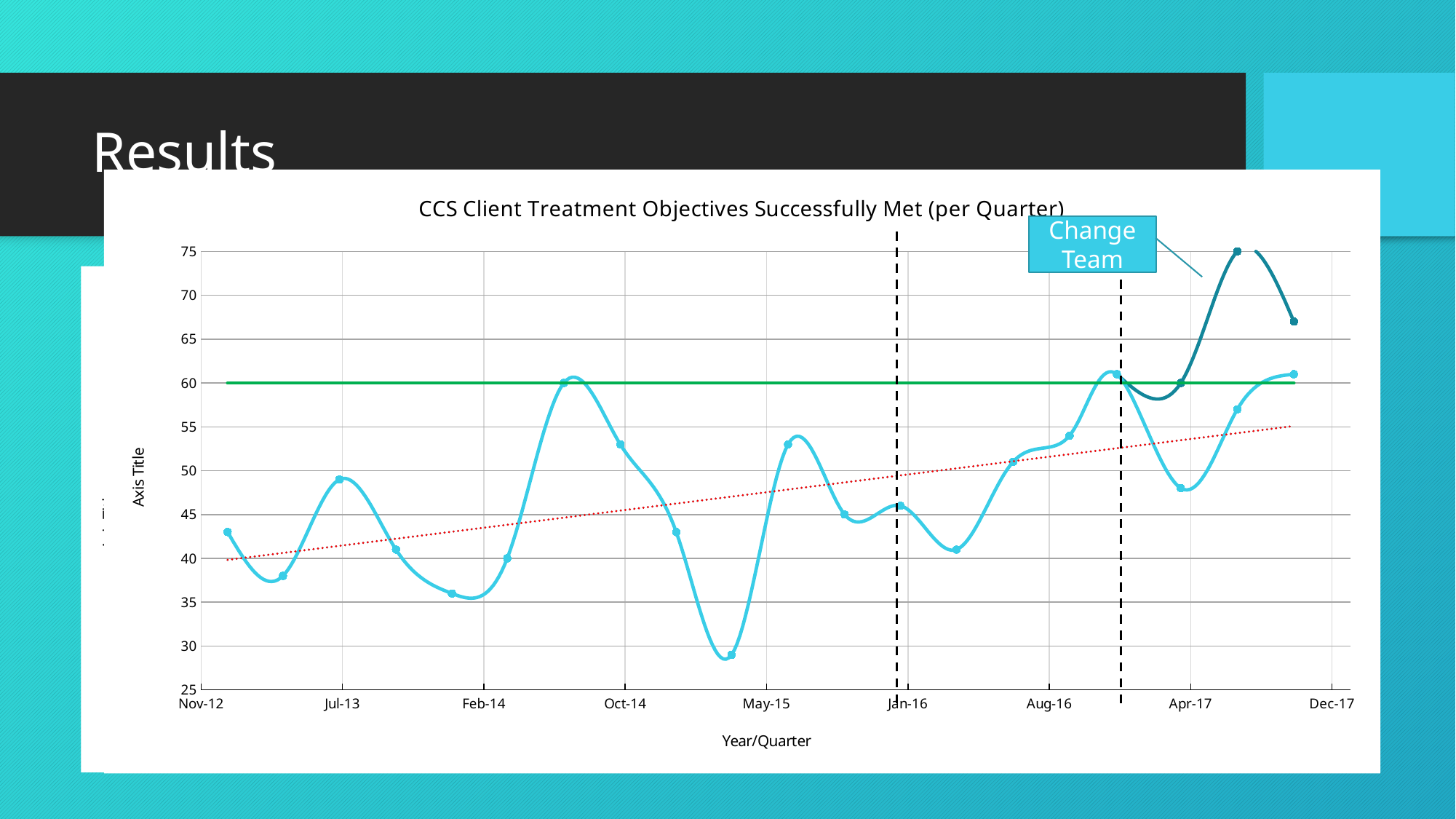
Is the lowest point of the light blue line greater or less than 35? less What kind of chart is shown on the slide? line chart Between which two x-axis labels does the highest point on the chart fall? Apr-17 and Dec-17 Does the red dotted trend line rise or fall from left to right? rises How many dashed vertical lines are drawn on the chart? 2 Is the highest point of the dark teal line greater or less than 70? greater What is the label on the x axis of the chart? Year/Quarter Is the first point of the light blue line, at Nov-12, greater or less than 40? greater What is the title of the chart? CCS Client Treatment Objectives Successfully Met (per Quarter) Between which two x-axis labels does the lowest point of the light blue line fall? Oct-14 and May-15 Which is larger: the light blue line's peak between Feb-14 and Oct-14, or its peak between May-15 and Jan-16? the peak between Feb-14 and Oct-14 At what value does the solid green horizontal line sit on the y axis? 60